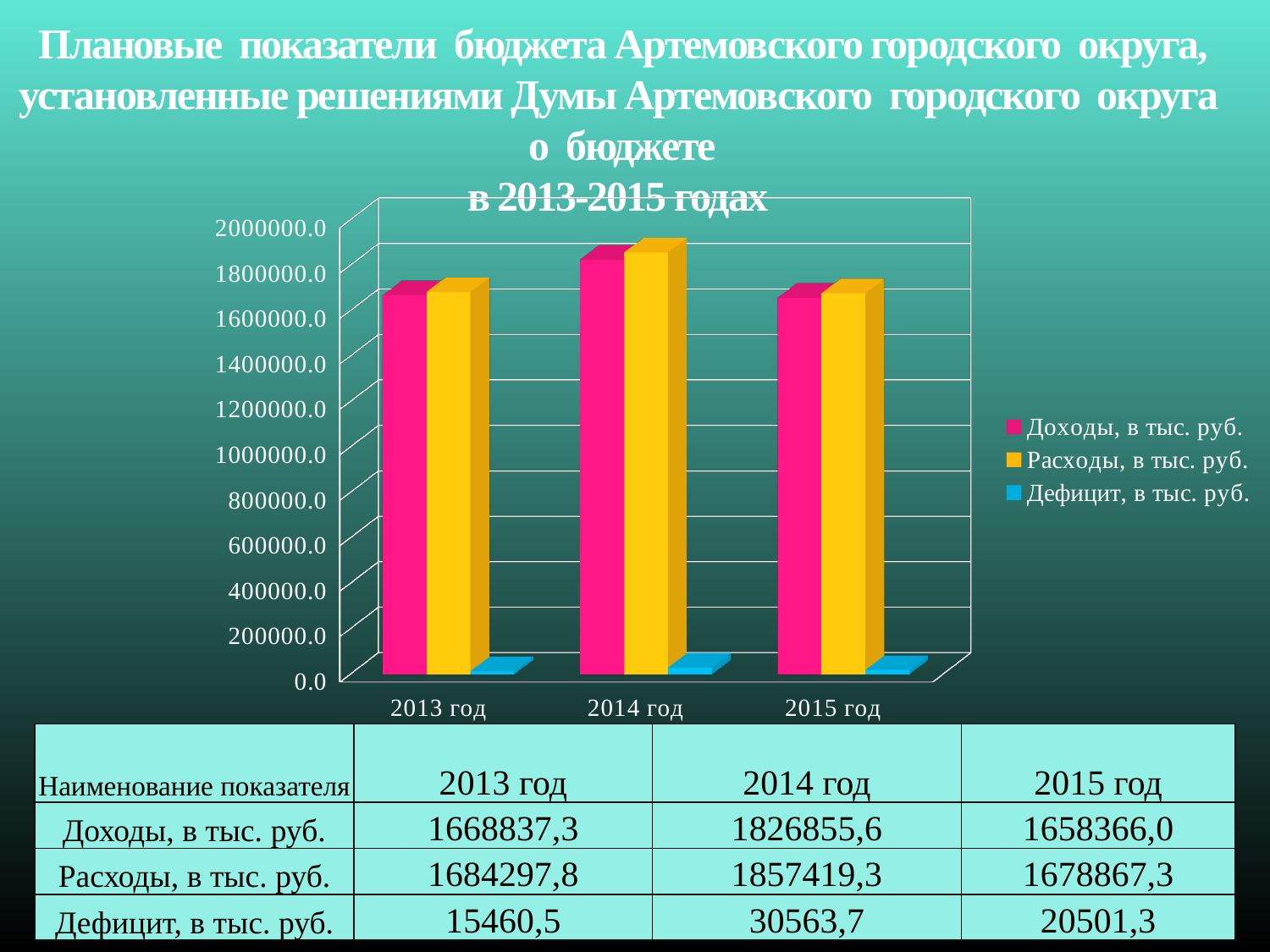
Which colour represents Дефицит, в тыс. руб. in the chart legend? blue In which year is Расходы, в тыс. руб. the highest? 2014 год What is the difference between Расходы and Доходы for 2013 год? 15460,5 What is the value of Доходы, в тыс. руб. for 2014 год? 1826855,6 How many years (categories) are shown on the x axis of the chart? 3 How many series does the chart legend list? 3 For 2014 год, which is larger: Доходы or Расходы? Расходы In which year is Дефицит, в тыс. руб. the lowest? 2013 год What is the value of Расходы, в тыс. руб. for 2013 год? 1684297,8 What is the value of Дефицит, в тыс. руб. for 2015 год? 20501,3 Is the value of Доходы for 2014 год greater or less than 1800000.0? greater What kind of chart is shown on the slide? bar chart